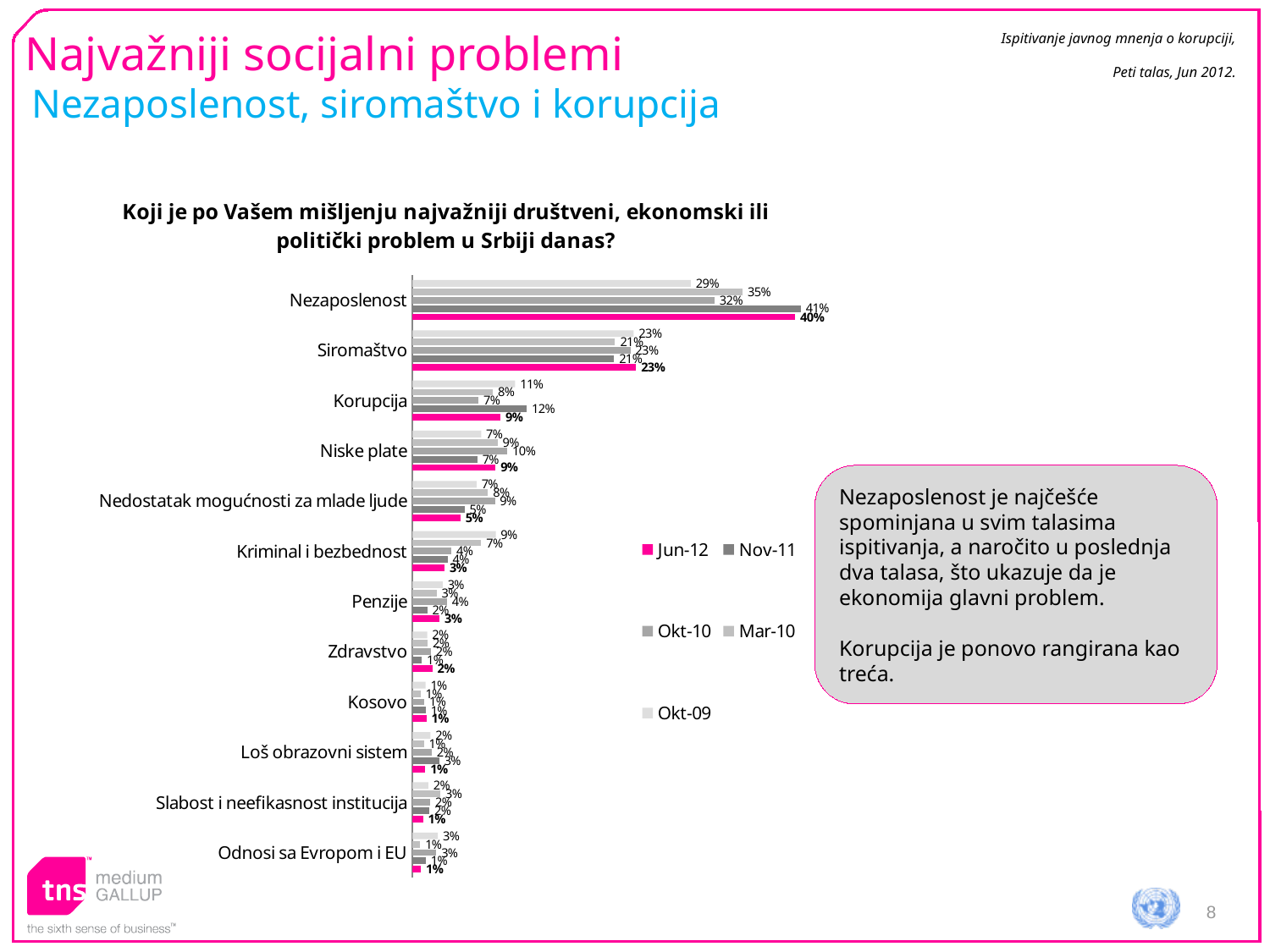
What is the Jun-12 value for Nezaposlenost? 40% What is the Jun-12 value for Korupcija? 9% What is the Jun-12 value for Siromaštvo? 23% What is the difference between the Jun-12 values for Nezaposlenost and Siromaštvo? 17% What is the highest value shown for Nezaposlenost across all waves? 41% How many series does the legend list? 5 Which is larger for Jun-12: Korupcija or Nedostatak mogućnosti za mlade ljude? Korupcija Which series is shown in pink in the legend? Jun-12 What type of chart is shown on the slide? bar chart Which category has the highest Jun-12 value? Nezaposlenost What is the Jun-12 value for Kriminal i bezbednost? 3% How many problem categories are shown on the chart? 12